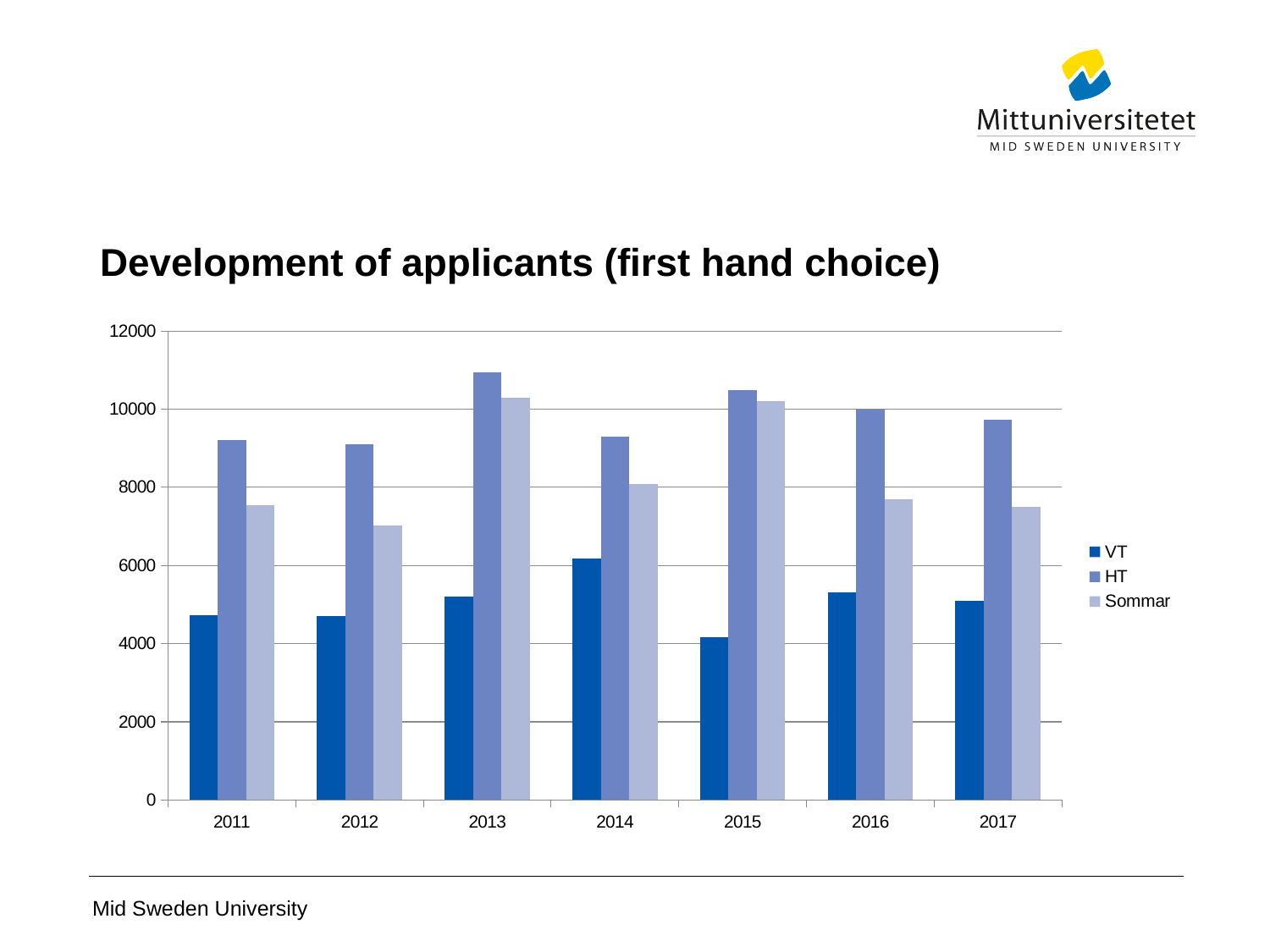
Is the Sommar value for 2011 greater or less than 8000? less Is the VT value for 2015 greater or less than 6000? less Which year has the highest VT value? 2014 Which year has the highest HT value? 2013 Which is larger, the VT value for 2014 or the VT value for 2011? 2014 What kind of chart is shown on the slide? bar chart Which year has the lowest VT value? 2015 What is the title of the chart? Development of applicants (first hand choice) Is the HT value for 2013 greater or less than 10000? greater How many years are shown on the x axis? 7 Which is larger in 2016, the HT value or the Sommar value? HT How many series does the legend list? 3